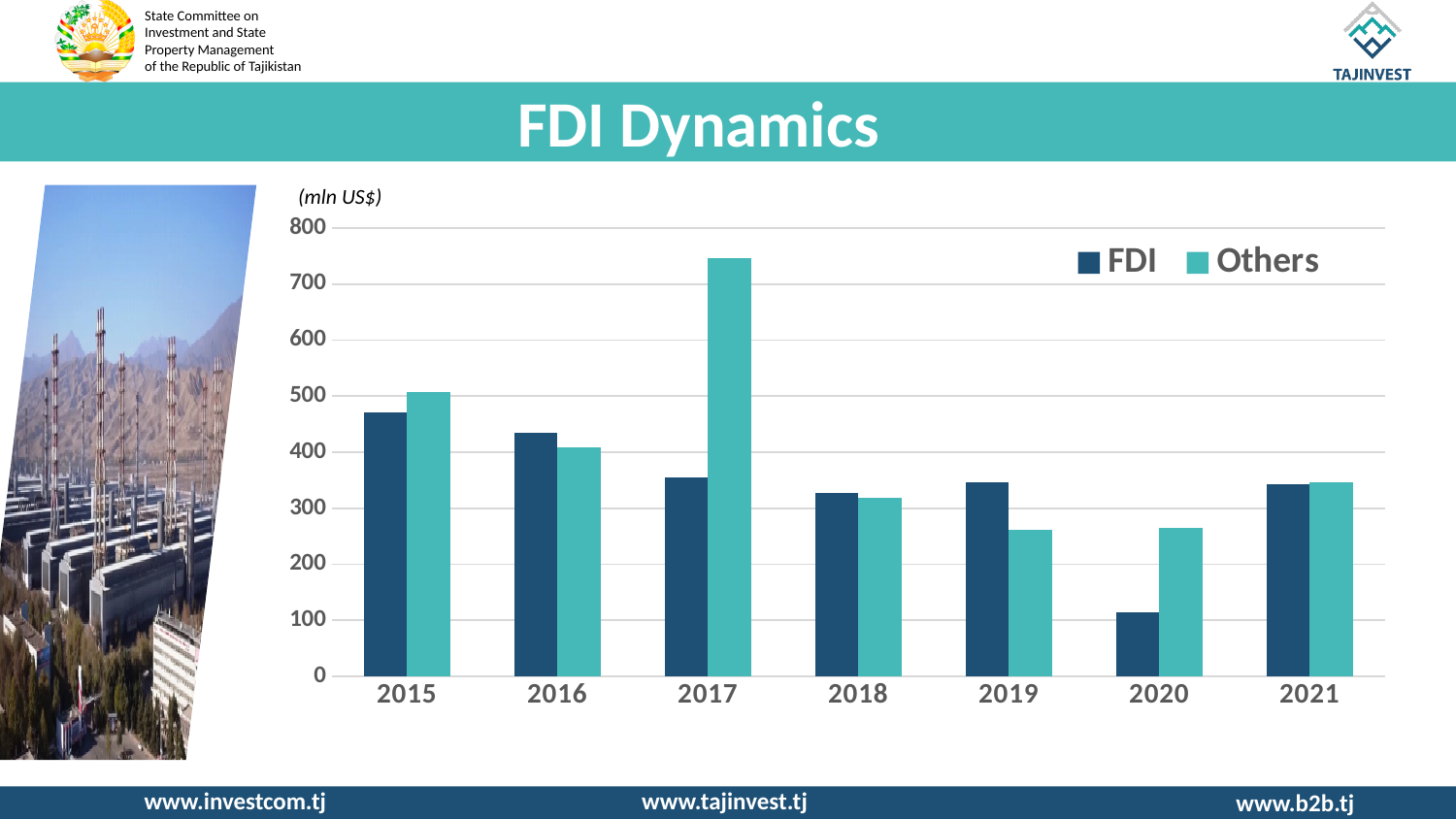
In which year is the FDI value highest? 2015 In which year is the FDI value lowest? 2020 Is the FDI value for 2020 greater or less than 200? less Is the FDI value for 2015 greater or less than 400? greater How many series does the legend list? 2 How many years are shown on the x axis? 7 What kind of chart is shown on the slide? bar chart In which year is the Others value highest? 2017 Is the Others value for 2017 greater or less than 700? greater In 2019, which is larger, FDI or Others? FDI In 2017, which is larger, FDI or Others? Others